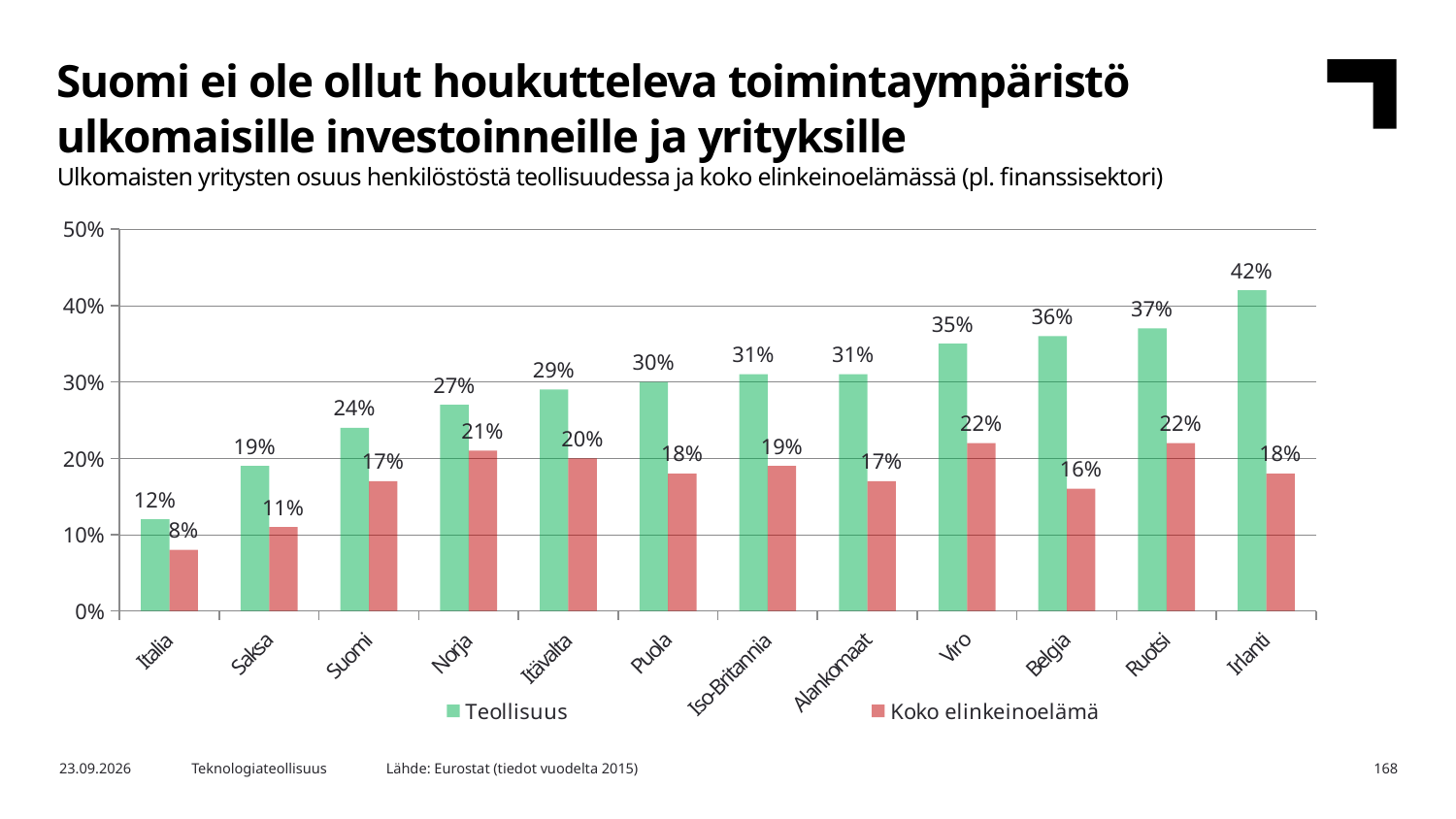
Which is larger, the Teollisuus value for Viro or the Teollisuus value for Ruotsi? Ruotsi Which colour represents the Koko elinkeinoelämä series? Red What is the Koko elinkeinoelämä value for Norja? 21% How many series does the legend list? 2 What kind of chart is shown on the slide? Bar chart Is the Teollisuus value for Puola greater or less than 20%? greater What is the Teollisuus value for Suomi? 24% What is the Teollisuus value for Irlanti? 42% Which country has the highest Teollisuus value? Irlanti Which country has the lowest Koko elinkeinoelämä value? Italia How many countries are shown on the x axis? 12 What is the difference between the Teollisuus and Koko elinkeinoelämä values for Belgia? 20%